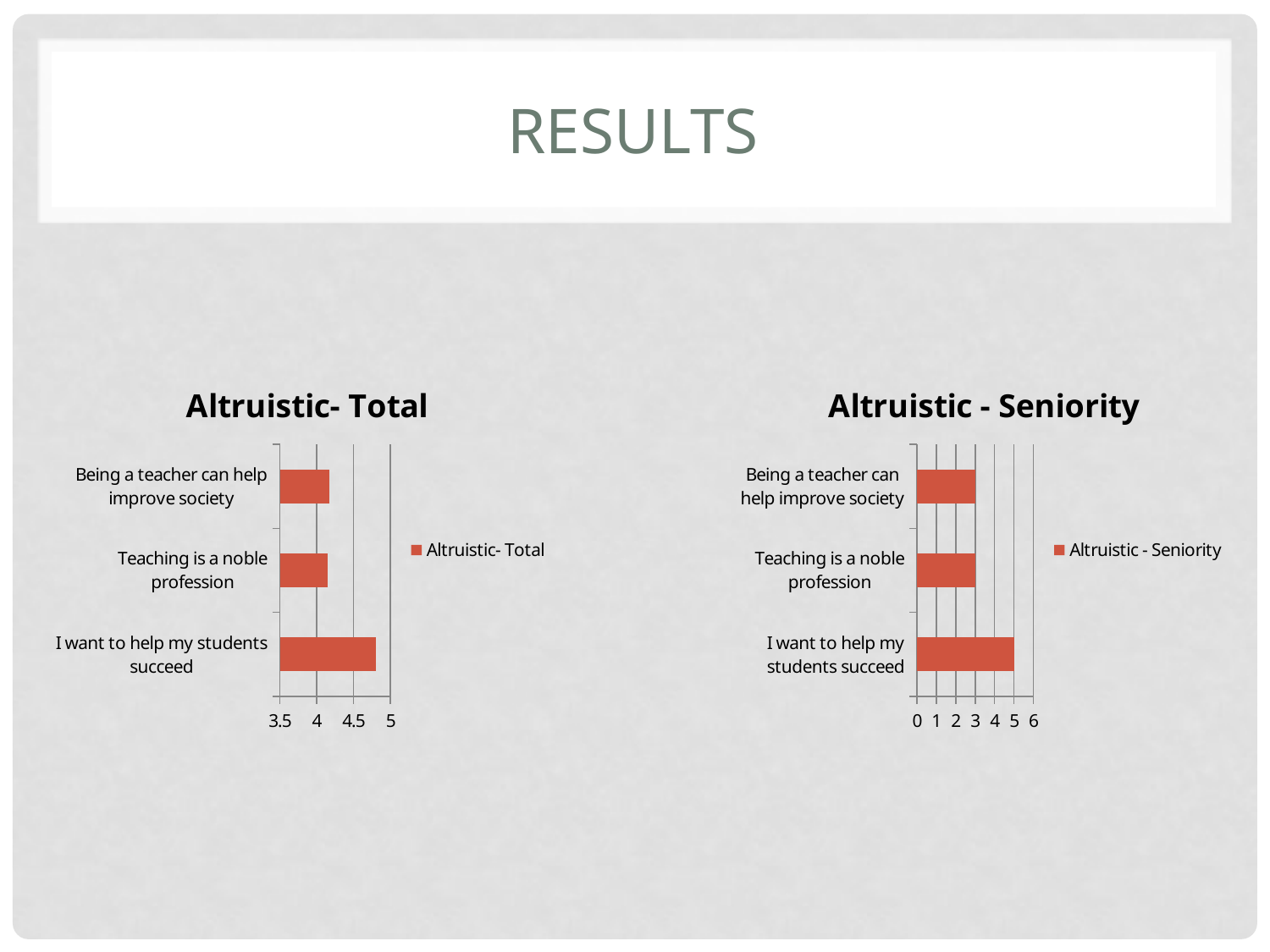
What is the legend entry shown in the "Altruistic - Seniority" chart? Altruistic - Seniority In the "Altruistic- Total" chart, is the value for "I want to help my students succeed" greater or less than 4.5? greater In the "Altruistic - Seniority" chart, is the value for "Being a teacher can help improve society" greater or less than 4? less In the "Altruistic- Total" chart, is the value for "Teaching is a noble profession" greater or less than 4.5? less In the "Altruistic - Seniority" chart, which category has the highest value? I want to help my students succeed In the "Altruistic- Total" chart, which category has the highest value? I want to help my students succeed What type of chart is the "Altruistic- Total" chart? bar chart How many categories are shown in the "Altruistic- Total" chart? 3 In the "Altruistic - Seniority" chart, which is larger: the value for "I want to help my students succeed" or the value for "Teaching is a noble profession"? I want to help my students succeed How many series does the legend of the "Altruistic- Total" chart list? 1